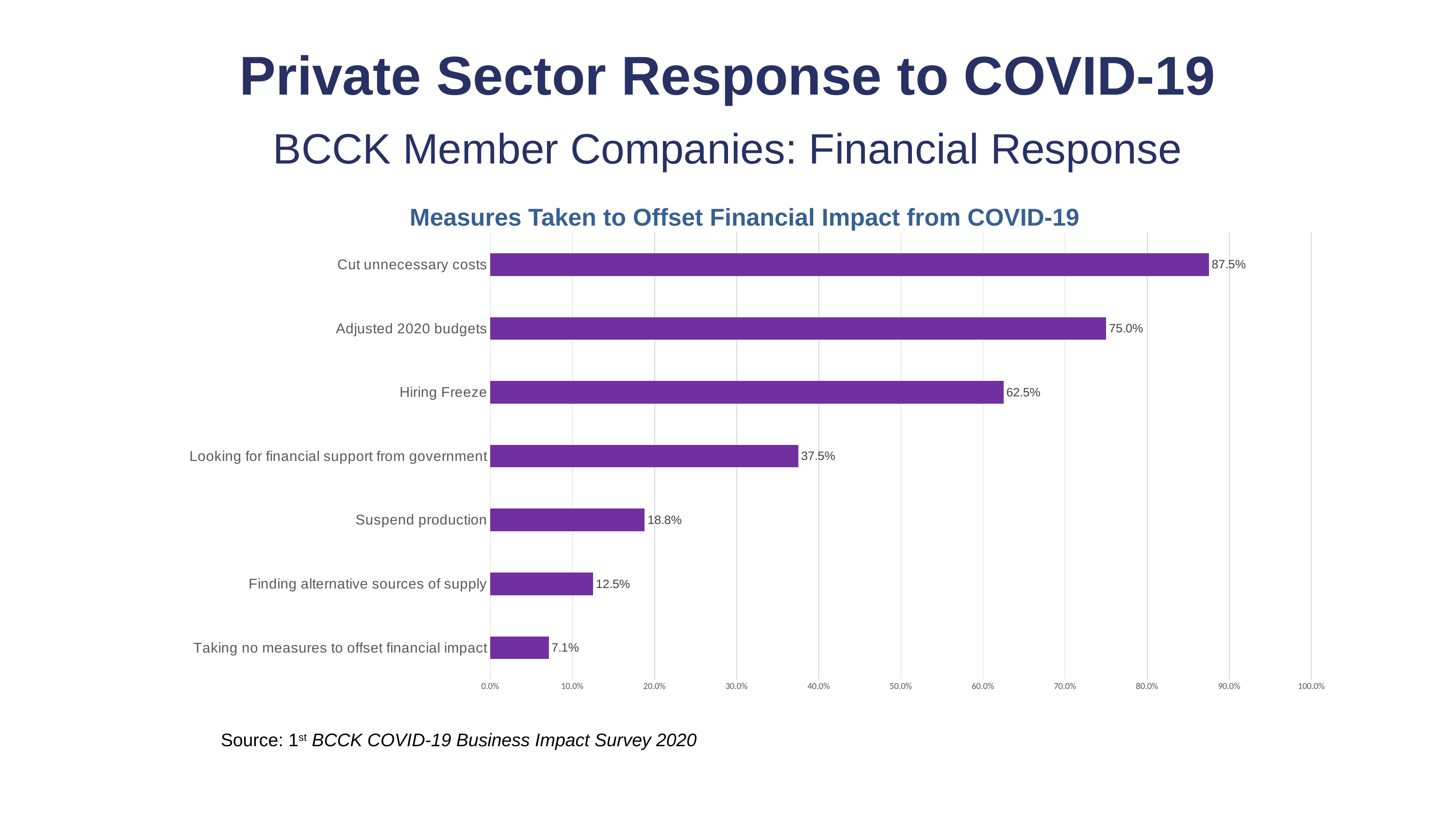
What is the value for Taking no measures to offset financial impact? 7.1% What is the difference between Adjusted 2020 budgets and Hiring Freeze? 12.5% Which is larger: Suspend production or Finding alternative sources of supply? Suspend production What is the value for Hiring Freeze? 62.5% Which measure has the highest percentage? Cut unnecessary costs What percentage of companies are looking for financial support from government? 37.5% Which category has the lowest value? Taking no measures to offset financial impact What percentage of companies cut unnecessary costs? 87.5% What type of chart is shown on the slide? Bar chart Is the value for Adjusted 2020 budgets greater or less than 70.0%? greater How many measures are shown in the chart? 7 What is the title of the chart? Measures Taken to Offset Financial Impact from COVID-19